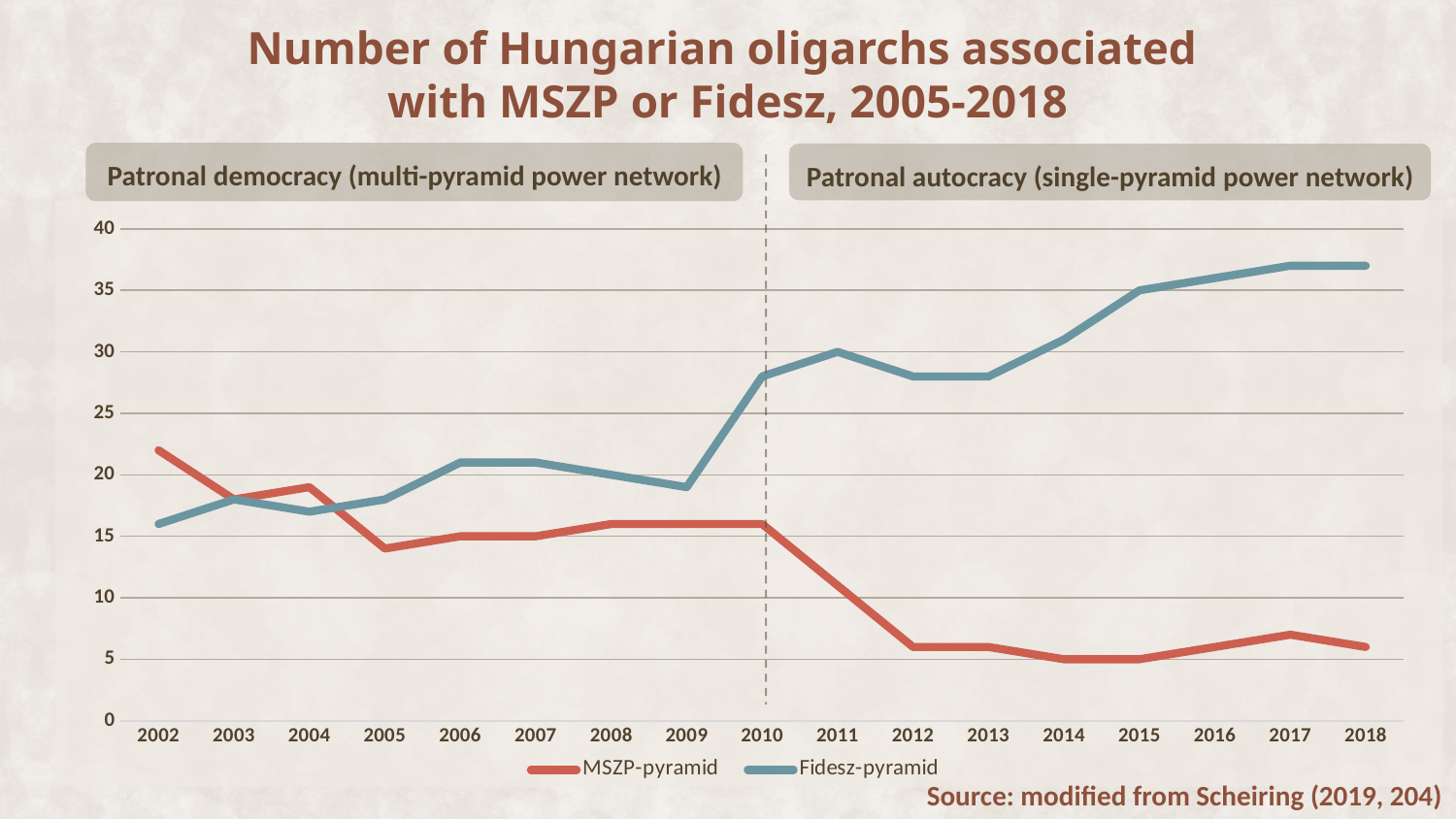
What label is shown above the left part of the chart, before the dashed line? Patronal democracy (multi-pyramid power network) What is the value of the MSZP-pyramid series in 2014? 5 In which year is the MSZP-pyramid series at its highest? 2002 How many years are plotted along the x axis? 17 Is the value for MSZP-pyramid in 2012 greater or less than 10? less Does the Fidesz-pyramid series rise or fall from 2010 to 2018? rise What is the value of the Fidesz-pyramid series in 2015? 35 What kind of chart is shown on the slide? line chart How many series does the legend list? 2 In 2010, which series has the larger value, MSZP-pyramid or Fidesz-pyramid? Fidesz-pyramid What is the value of the Fidesz-pyramid series in 2011? 30 Is the value for Fidesz-pyramid in 2018 greater or less than 35? greater